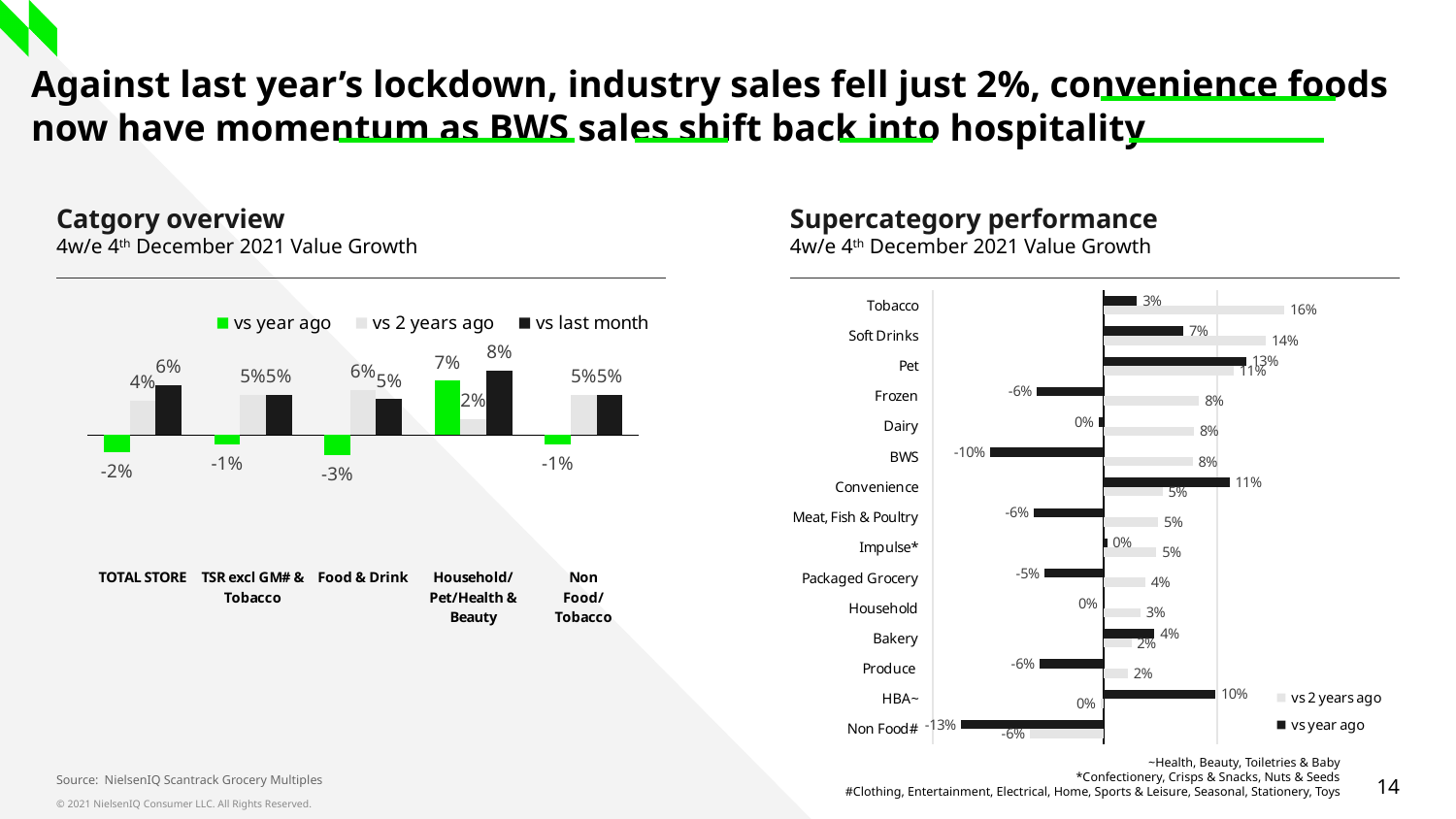
In the Catgory overview chart, what is the vs year ago value for Household/Pet/Health & Beauty? 7% In the Supercategory performance chart, which category has the lowest vs year ago value? Non Food# In the Supercategory performance chart, what is the vs year ago value for BWS? -10% In the Catgory overview chart, is the vs last month value for Household/Pet/Health & Beauty larger or smaller than that for Food & Drink? larger In the Supercategory performance chart, how many categories are plotted? 15 In the Supercategory performance chart, what is the difference between the vs 2 years ago and vs year ago values for Frozen? 14 percentage points In the Catgory overview chart, which category has the lowest vs year ago value? Food & Drink In the Supercategory performance chart, which category has the highest vs 2 years ago value? Tobacco In the Supercategory performance chart, what is the vs 2 years ago value for Tobacco? 16% What type of chart is the Supercategory performance chart? Bar chart In the Catgory overview chart, how many series does the legend list? 3 In the Catgory overview chart, what is the vs last month value for TOTAL STORE? 6%